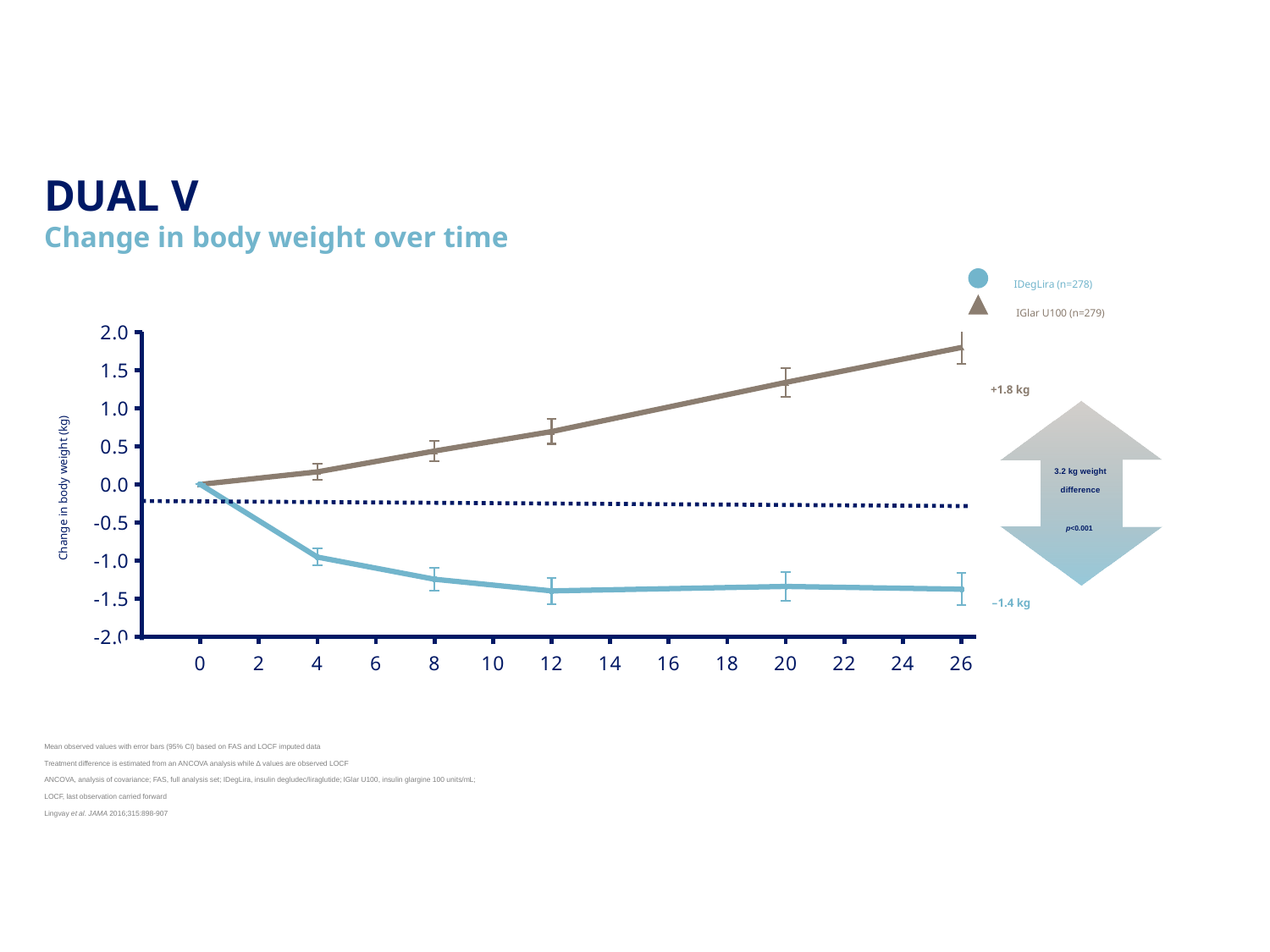
Is the value for IGlar U100 at week 12 greater or less than 1.0? less What is the change in body weight at week 26 for IGlar U100 (n=279), as labelled on the chart? +1.8 kg How many series does the legend list? 2 Is the value for IDegLira at week 4 greater or less than -0.5? less What kind of chart is shown on the slide? line chart What is the p-value shown for the weight difference between the groups? p<0.001 Is the value for IGlar U100 at week 20 greater or less than 1.0? greater Does the IGlar U100 line rise or fall from week 0 to week 26? rise What is the weight difference between the two treatment groups stated on the slide? 3.2 kg Which series shows the higher change in body weight at week 26? IGlar U100 (n=279) What is the change in body weight at week 26 for IDegLira (n=278), as labelled on the chart? –1.4 kg Which series shows the lowest change in body weight at week 26? IDegLira (n=278)